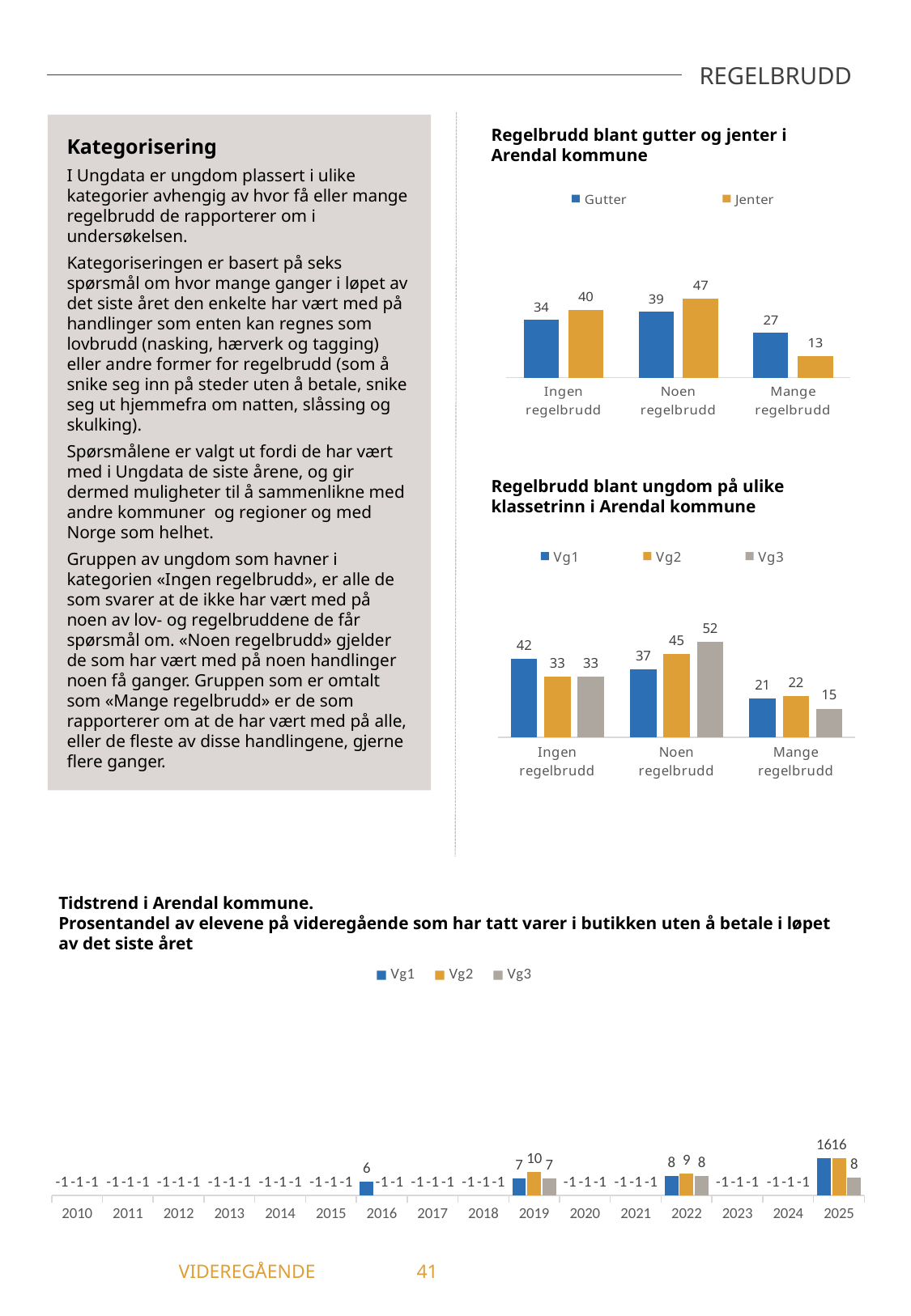
In the chart 'Regelbrudd blant gutter og jenter i Arendal kommune', what is the value for Jenter in the 'Noen regelbrudd' category? 47 In the chart 'Regelbrudd blant gutter og jenter i Arendal kommune', which category has the lowest value for Jenter? Mange regelbrudd In the chart 'Regelbrudd blant gutter og jenter i Arendal kommune', what is the difference between Gutter and Jenter in the 'Mange regelbrudd' category? 14 How many series does the legend list in the chart 'Regelbrudd blant gutter og jenter i Arendal kommune'? 2 How many categories are shown on the x axis of the chart 'Regelbrudd blant ungdom på ulike klassetrinn i Arendal kommune'? 3 In the chart 'Regelbrudd blant ungdom på ulike klassetrinn i Arendal kommune', which series has the highest value in the 'Ingen regelbrudd' category? Vg1 In the chart 'Tidstrend i Arendal kommune', what is the value for Vg2 in 2019? 10 In the chart 'Regelbrudd blant ungdom på ulike klassetrinn i Arendal kommune', is the value for Vg2 in 'Mange regelbrudd' larger or smaller than the value for Vg3 in the same category? larger What kind of chart is 'Tidstrend i Arendal kommune'? Bar chart In the chart 'Tidstrend i Arendal kommune', what is the value for Vg3 in 2025? 8 In the chart 'Regelbrudd blant ungdom på ulike klassetrinn i Arendal kommune', what is the value for Vg3 in the 'Noen regelbrudd' category? 52 In the chart 'Regelbrudd blant gutter og jenter i Arendal kommune', what is the value for Gutter in the 'Mange regelbrudd' category? 27